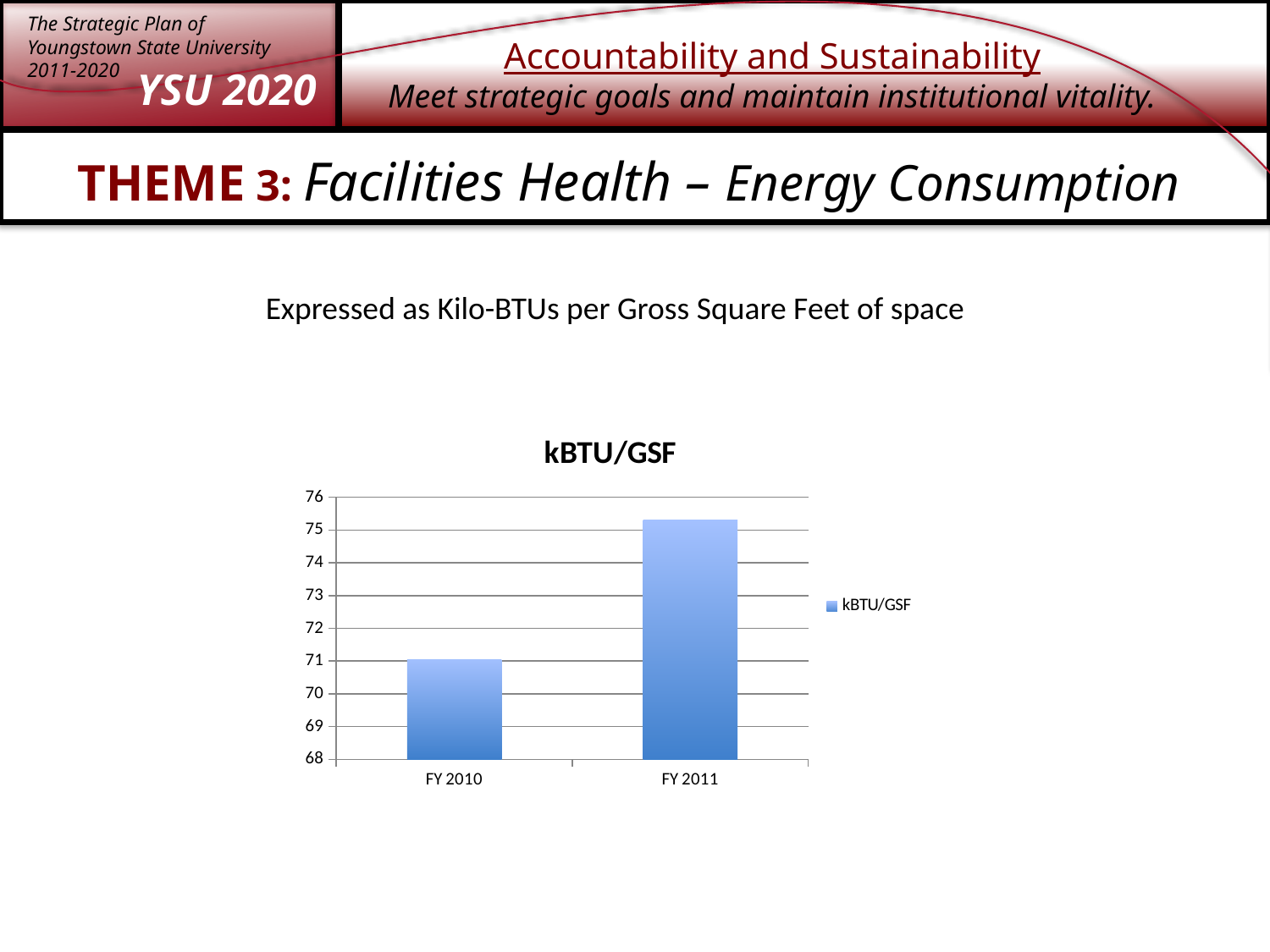
How many categories are shown on the x axis of the chart? 2 Which fiscal year has the lowest kBTU/GSF value? FY 2010 Is the value for FY 2011 greater or less than 74? greater Do the values rise or fall from FY 2010 to FY 2011? rise Which is larger, the value for FY 2010 or FY 2011? FY 2011 Is the value for FY 2011 greater or less than 76? less Is the value for FY 2010 greater or less than 72? less What is the title of the chart? kBTU/GSF How many series does the legend list? 1 Which fiscal year has the highest kBTU/GSF value? FY 2011 What kind of chart is shown on the slide? bar chart